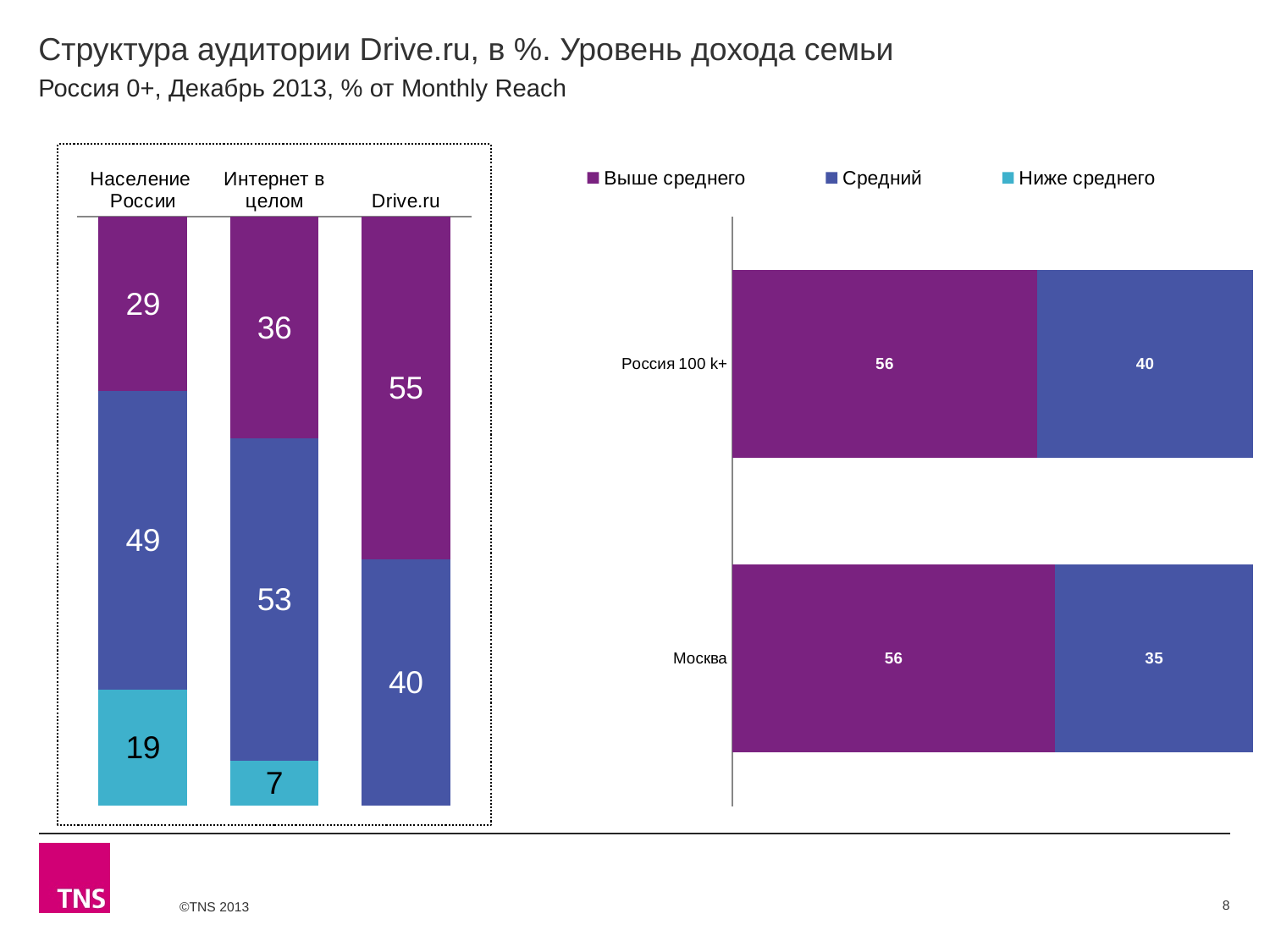
In the right chart, what is the difference between the Средний values for Россия 100 k+ and Москва? 5 In the right chart, what is the value of the Средний segment for Москва? 35 In the left chart, what is the value of the Средний segment for Интернет в целом? 53 In the left chart, which category has the highest Выше среднего value? Drive.ru In the left chart, which category has the lowest Ниже среднего value among those labelled? Интернет в целом How many series does the legend list? 3 In the left chart, what is the value of the Ниже среднего segment for Население России? 19 In the left chart, what is the value of the Выше среднего segment for Drive.ru? 55 How many categories does the right chart show? 2 In the left chart, which is larger: the Средний value for Население России or for Drive.ru? Население России In the left chart, what is the difference between the Выше среднего values for Drive.ru and Население России? 26 In the right chart, what is the value of the Выше среднего segment for Россия 100 k+? 56